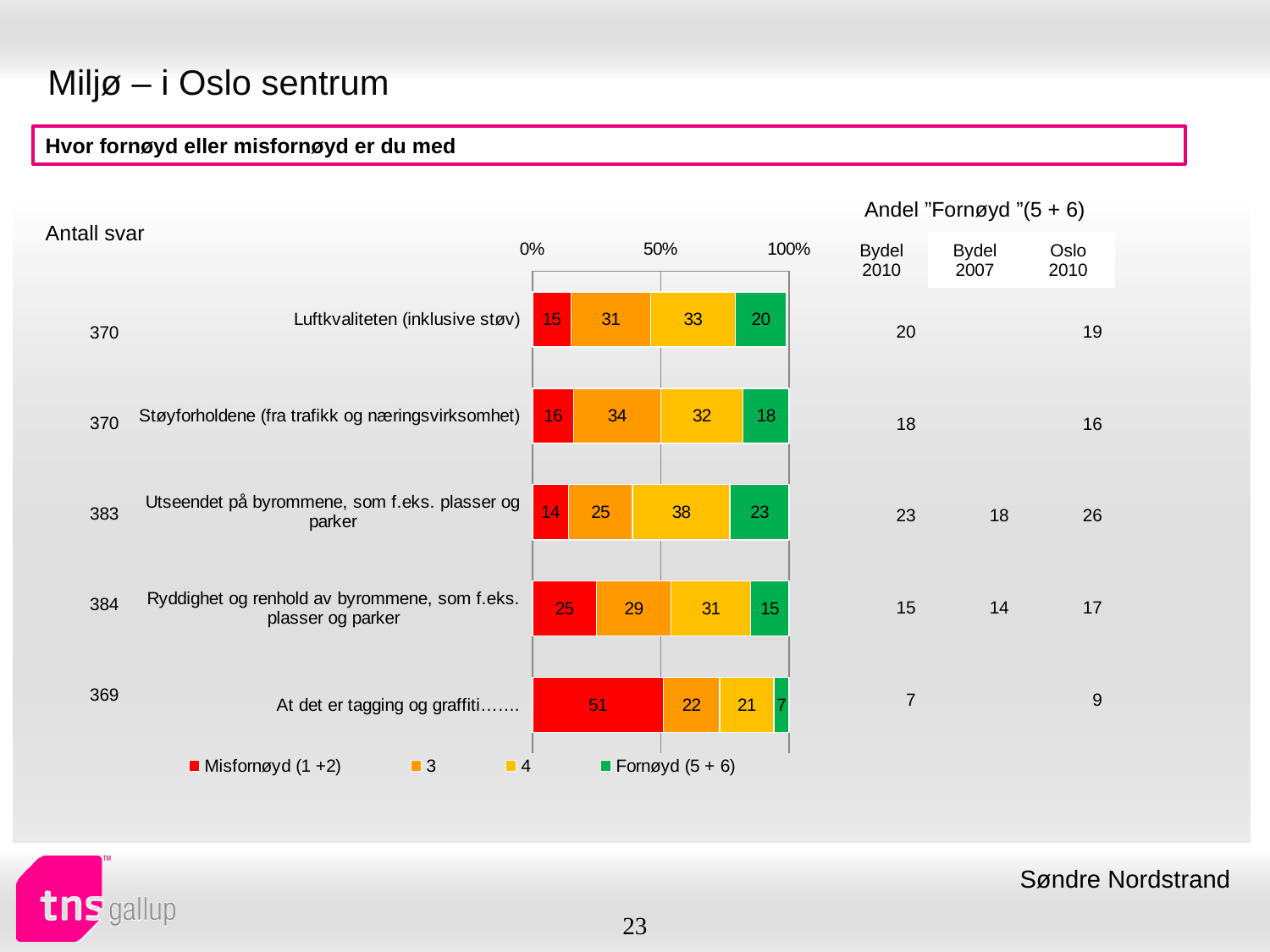
What is the value of "Fornøyd (5 + 6)" for "Luftkvaliteten (inklusive støv)"? 20 Which is larger: the "Fornøyd (5 + 6)" value for "Støyforholdene (fra trafikk og næringsvirksomhet)" or for "Utseendet på byrommene, som f.eks. plasser og parker"? Utseendet på byrommene, som f.eks. plasser og parker Which category has the lowest "Fornøyd (5 + 6)" value? At det er tagging og graffiti……. What is the total of the stacked bar for "Støyforholdene (fra trafikk og næringsvirksomhet)"? 100 What colour represents "Fornøyd (5 + 6)" in the chart? green What is the difference between the "Misfornøyd (1 +2)" values for "Ryddighet og renhold av byrommene, som f.eks. plasser og parker" and "Luftkvaliteten (inklusive støv)"? 10 How many series does the legend list? 4 What kind of chart is shown on the slide? stacked bar chart How many categories are plotted in the chart? 5 What is the value of series "4" for "Utseendet på byrommene, som f.eks. plasser og parker"? 38 What is the value of "Misfornøyd (1 +2)" for "At det er tagging og graffiti……."? 51 Which category has the highest "Misfornøyd (1 +2)" value? At det er tagging og graffiti…….